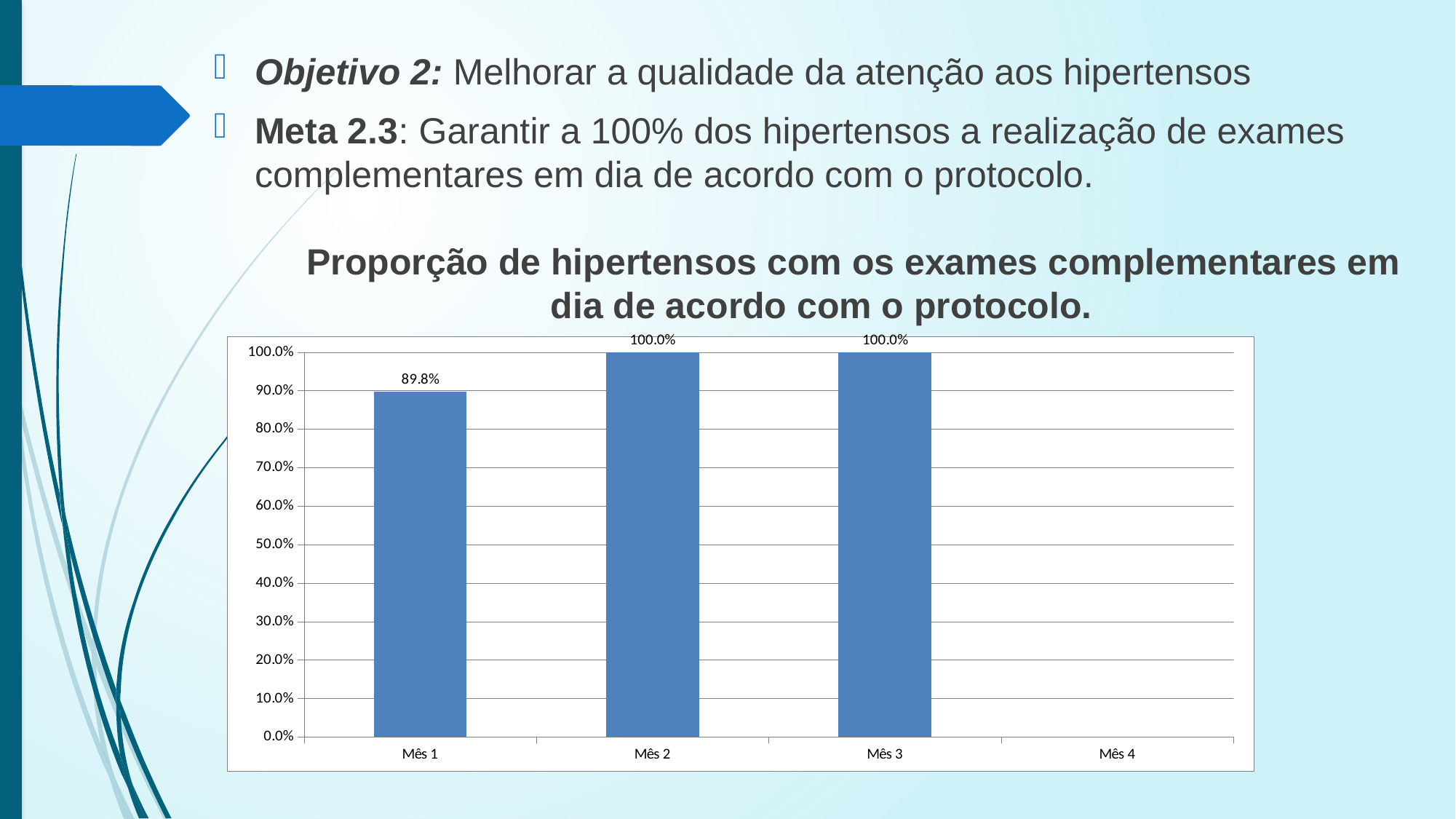
What is the value for Mês 1? 89.8% What kind of chart is shown on the slide? Bar chart Which month has the lowest value among the months with a plotted bar? Mês 1 How many categories are shown on the x axis? 4 Is the value for Mês 1 greater or less than 80.0%? greater What is the value for Mês 3? 100.0% Which is larger, the value for Mês 1 or the value for Mês 3? Mês 3 What is the title of the chart? Proporção de hipertensos com os exames complementares em dia de acordo com o protocolo. How many months have a bar plotted? 3 What is the value for Mês 2? 100.0% Do the values rise or fall from Mês 1 to Mês 2? Rise What is the difference between the values for Mês 2 and Mês 1? 10.2%